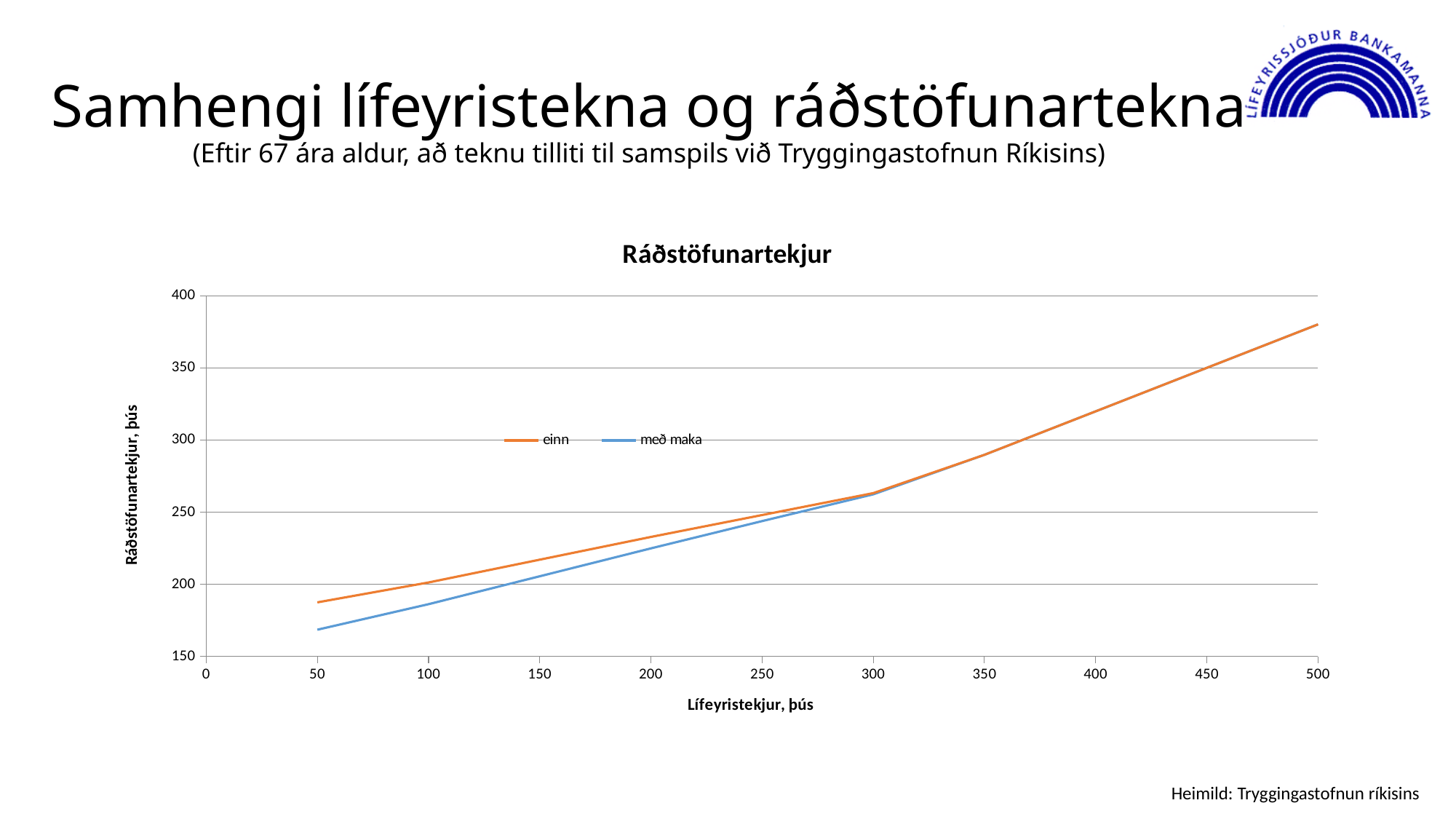
At Lífeyristekjur 100, which series has the lower value, 'einn' or 'með maka'? með maka What is the label of the x axis? Lífeyristekjur, þús What kind of chart is shown on the slide? line chart How many series does the legend list? 2 Is the value for 'einn' at Lífeyristekjur 50 greater or less than 200? less Is the value for 'einn' at Lífeyristekjur 500 greater or less than 350? greater Is the value for 'einn' at Lífeyristekjur 200 greater or less than 250? less What is the title of the chart? Ráðstöfunartekjur At Lífeyristekjur 50, which series has the higher value, 'einn' or 'með maka'? einn Do the values of the 'einn' series rise or fall as Lífeyristekjur increases along the x axis? rise